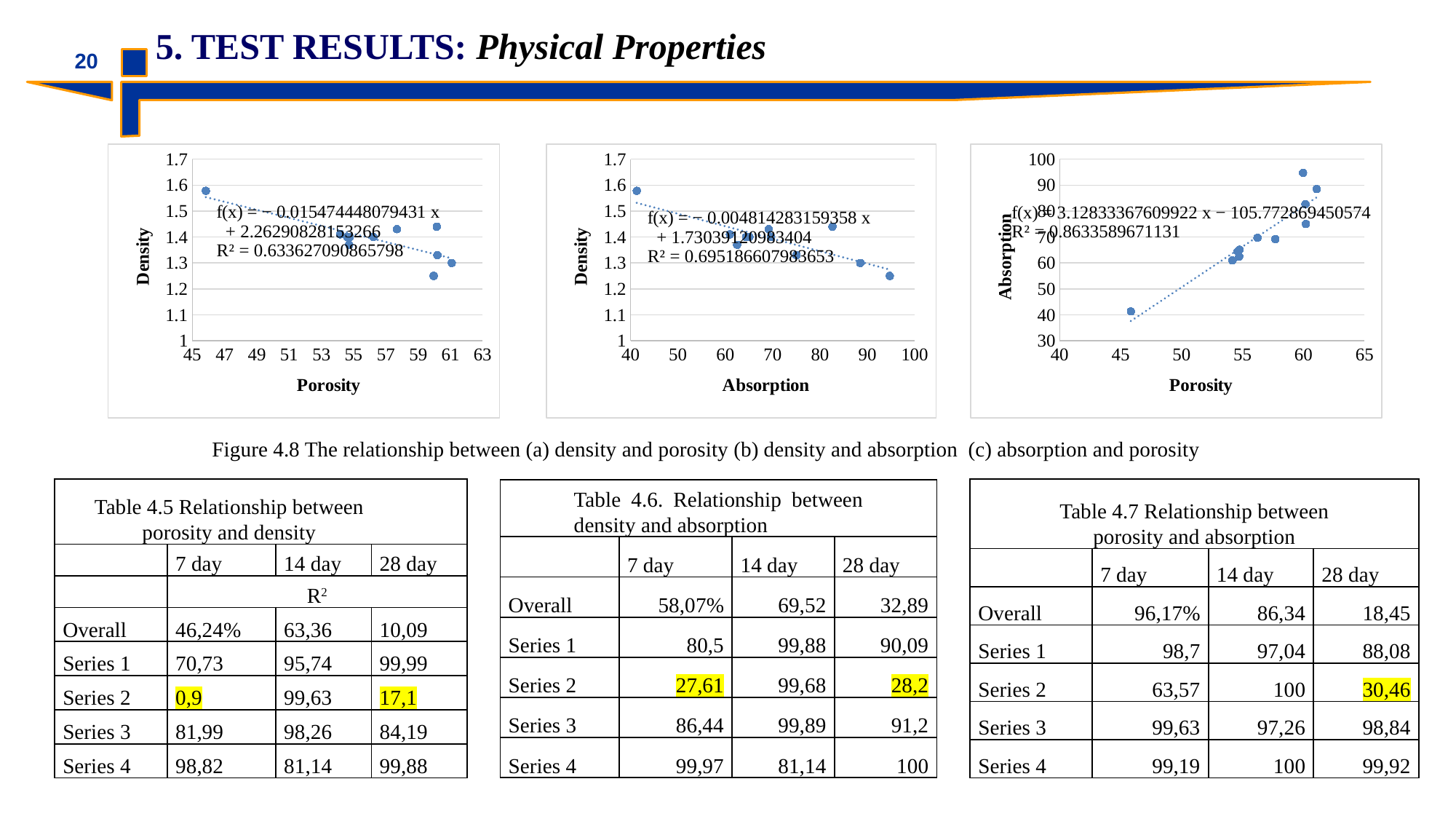
What R² value is printed on the right chart (Absorption vs Porosity)? 0.8633589671131 In the right chart (Absorption vs Porosity), is the highest plotted absorption value greater or less than 90? greater In the middle chart (Density vs Absorption), is the density of the point at the highest absorption (about 95) greater or less than 1.3? less What is the x-axis title of the middle chart? Absorption What kind of chart is the left chart (Density vs Porosity)? scatter chart In the right chart (Absorption vs Porosity), does absorption rise or fall as porosity increases? rise In the middle chart (Density vs Absorption), which point has the higher density: the one at absorption about 41 or the one at absorption about 95? the one at absorption about 41 In the middle chart (Density vs Absorption), does density rise or fall as absorption increases? fall In the left chart (Density vs Porosity), is the density of the point at the lowest porosity (about 46) greater or less than 1.5? greater In the left chart (Density vs Porosity), does density rise or fall as porosity increases? fall